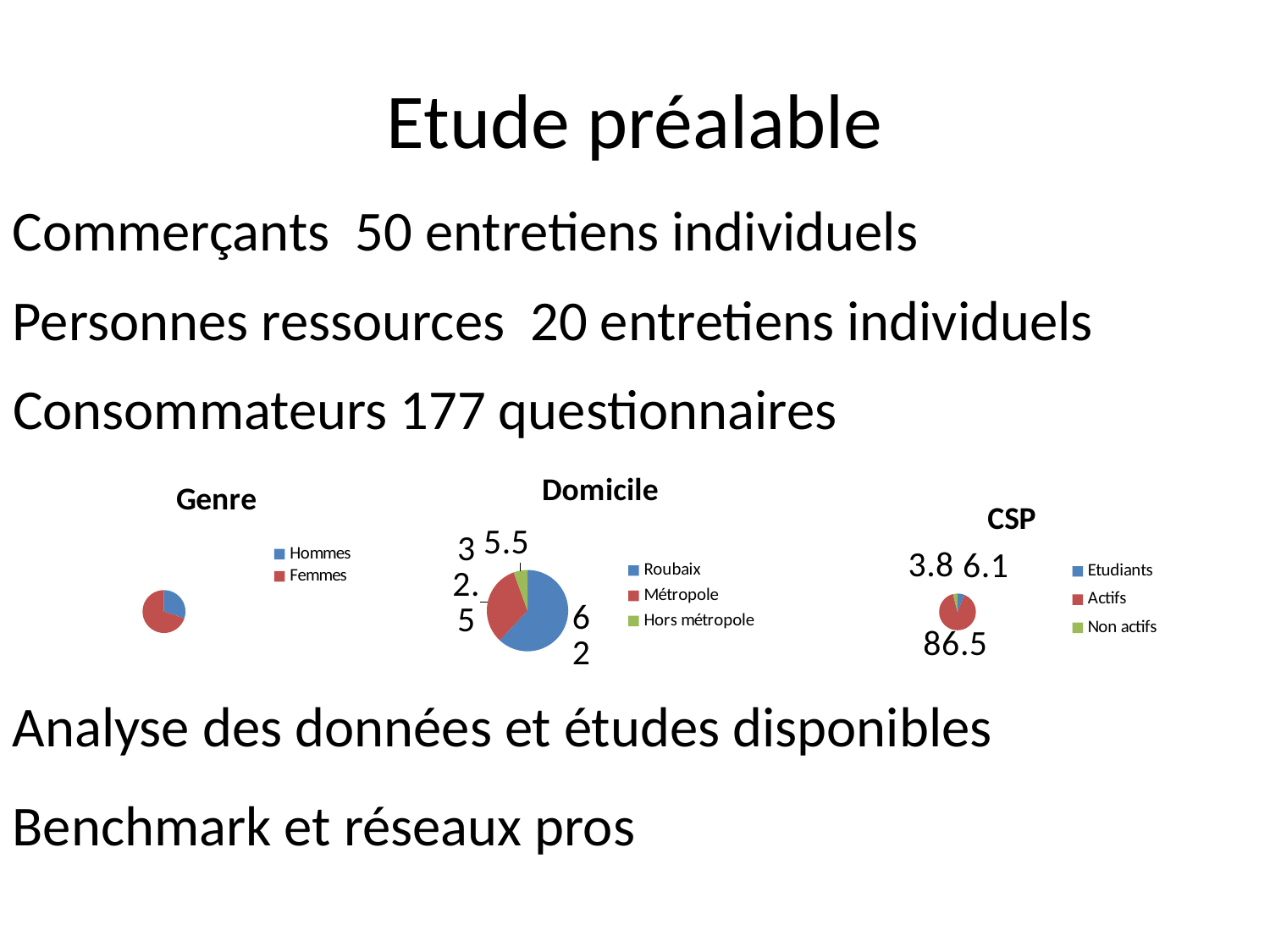
In the CSP chart, which is larger, Actifs or Etudiants? Actifs In the CSP chart, which category has the largest slice? Actifs How many categories does the legend of the Domicile chart list? 3 How many categories does the legend of the Genre chart list? 2 In the Domicile chart, which category has the smallest slice? Hors métropole What type of chart is the Genre chart? pie chart How many categories does the legend of the CSP chart list? 3 In the Domicile chart, which category has the largest slice? Roubaix In the CSP chart, what is the value shown for Actifs? 86.5 In the Domicile chart, what is the value shown for Hors métropole? 5.5 In the Genre chart, which category has the larger share, Hommes or Femmes? Femmes What is the title of the chart on the right of the slide? CSP